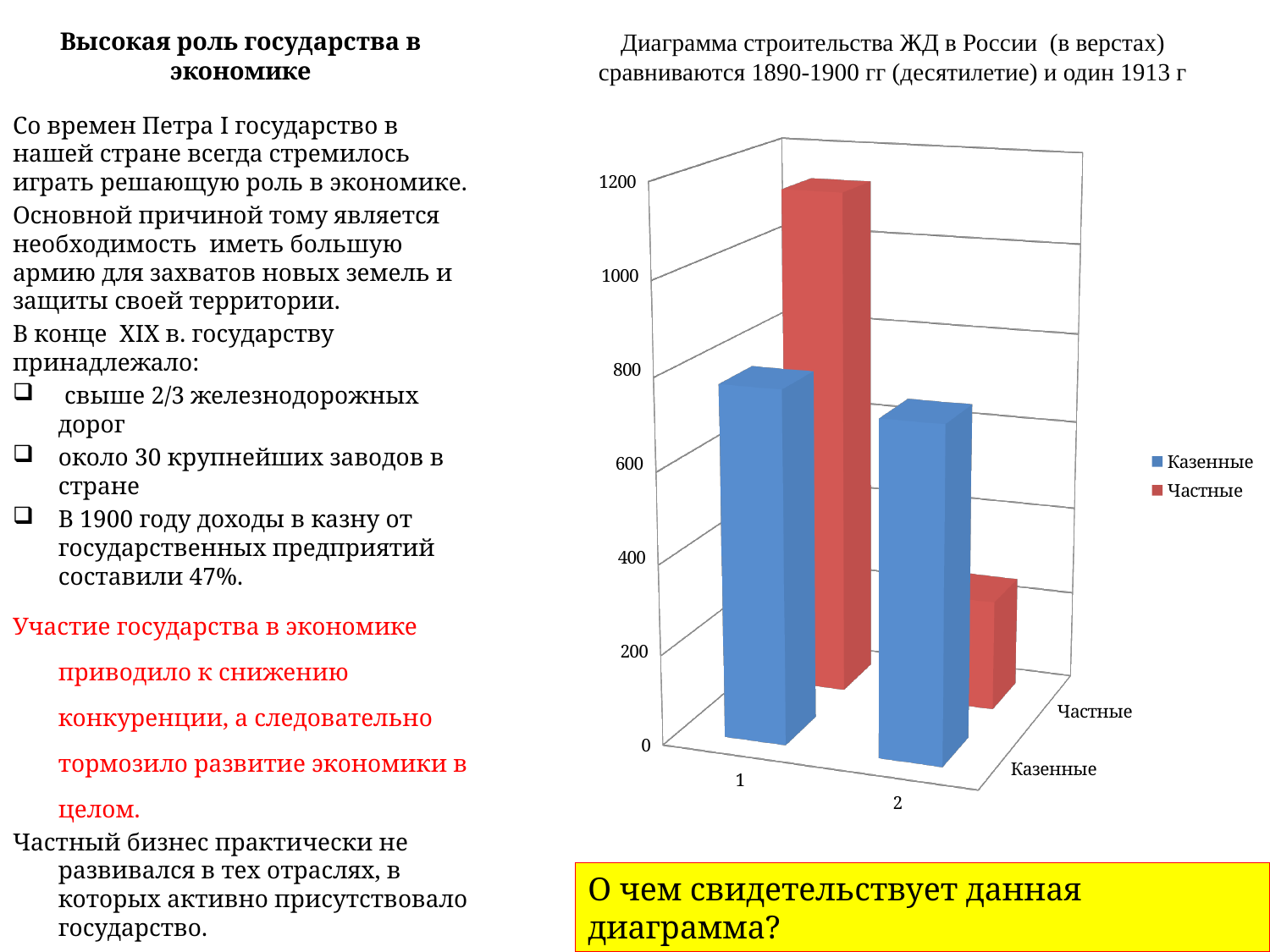
Is the value for Частные in category 1 greater or less than 1000? greater Does the value for Частные rise or fall from category 1 to category 2? fall What are the two series named in the chart legend? Казенные, Частные How many series does the chart legend list? 2 Which series is shown in red in the chart? Частные What kind of chart is shown on the slide? bar chart How many categories are shown on the x axis of the chart? 2 Is the value for Казенные in category 2 greater or less than 400? greater In category 1, which series has the larger value, Казенные or Частные? Частные In category 2, which series has the larger value, Казенные or Частные? Казенные Is the value for Казенные in category 1 greater or less than 1000? less